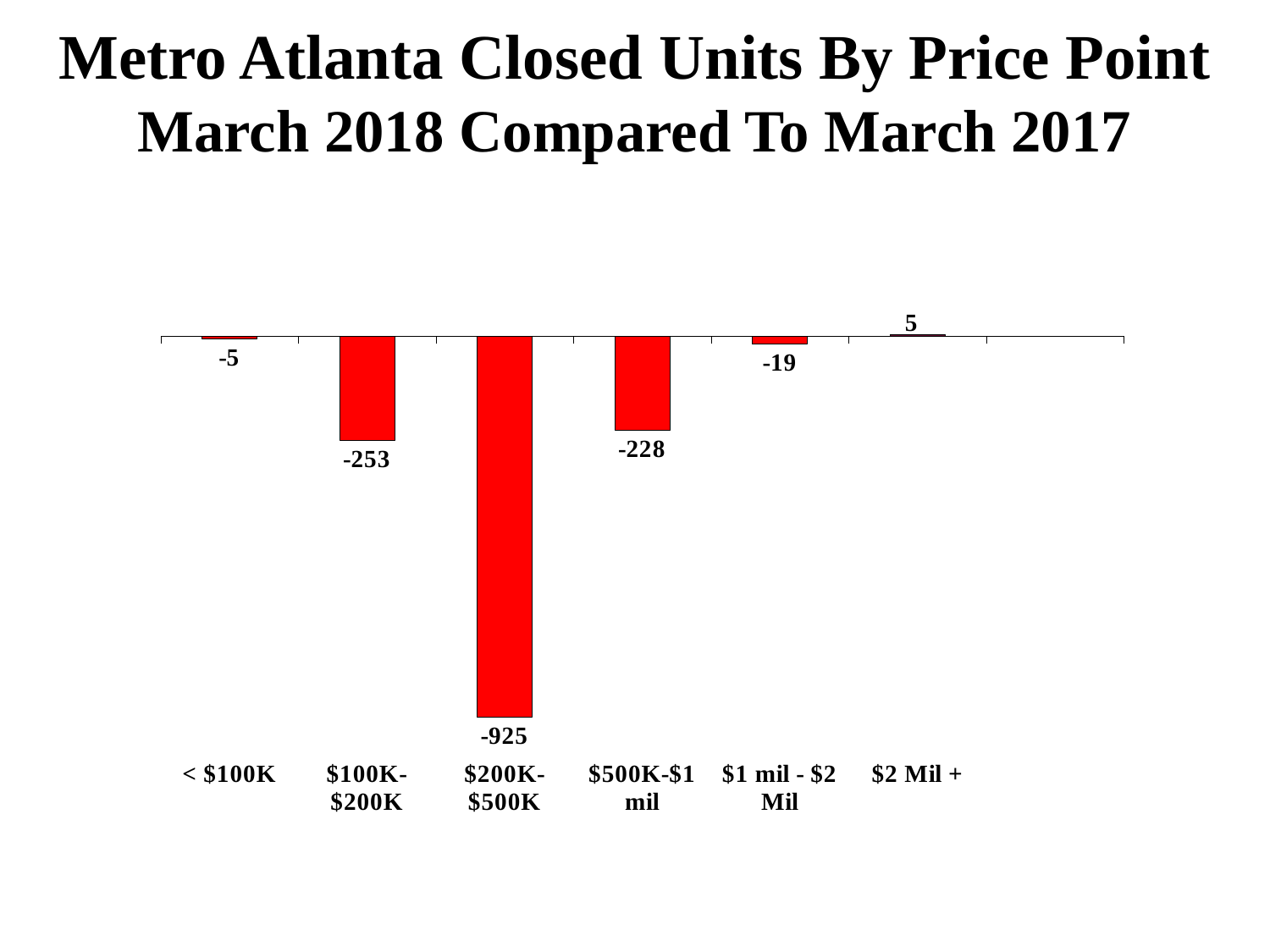
What kind of chart is shown on the slide? Bar chart What is the value for the $2 Mil + price point? 5 What colour are the bars in the chart? Red What is the value for the $200K-$500K price point? -925 What is the value for the $500K-$1 mil price point? -228 Which is larger, the value for $1 mil - $2 Mil or the value for < $100K? < $100K Which price point has the highest value? $2 Mil + What is the value for the < $100K price point? -5 How many price point categories are shown on the chart? 6 Which price point has the lowest value? $200K-$500K What is the value for the $100K-$200K price point? -253 What is the difference between the values for $100K-$200K and $500K-$1 mil? 25